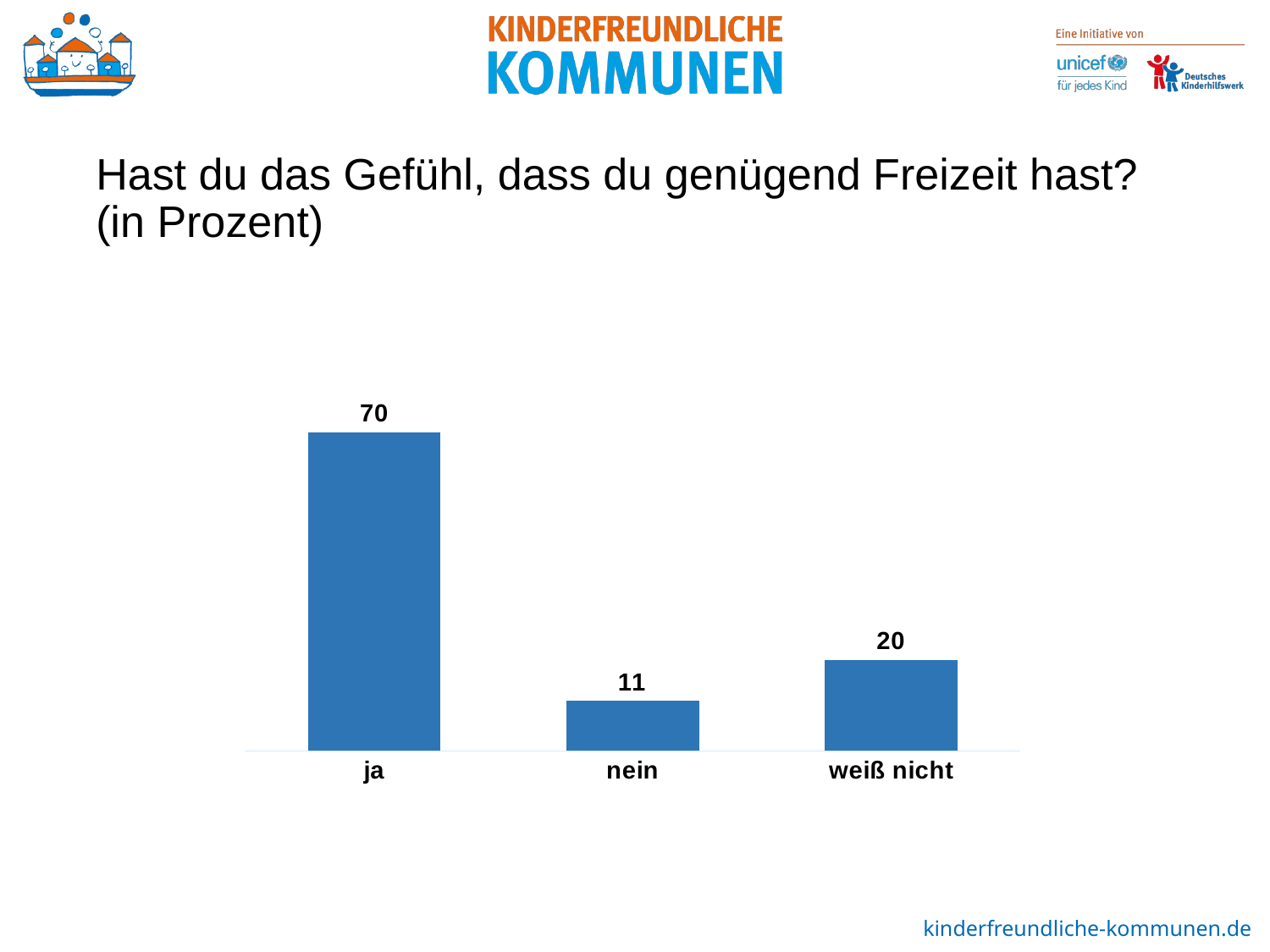
What value is shown for "weiß nicht"? 20 What question does the slide title say the chart answers? Hast du das Gefühl, dass du genügend Freizeit hast? (in Prozent) What is the total of the three values shown in the chart? 101 What kind of chart is shown on the slide? bar chart What is the difference between the values for "ja" and "nein"? 59 How many categories are shown in the chart? 3 What value is shown for "ja"? 70 Which category has the lowest value? nein Which is larger, the value for "weiß nicht" or the value for "nein"? weiß nicht Which category has the highest value? ja What value is shown for "nein"? 11 What is the difference between the values for "weiß nicht" and "nein"? 9